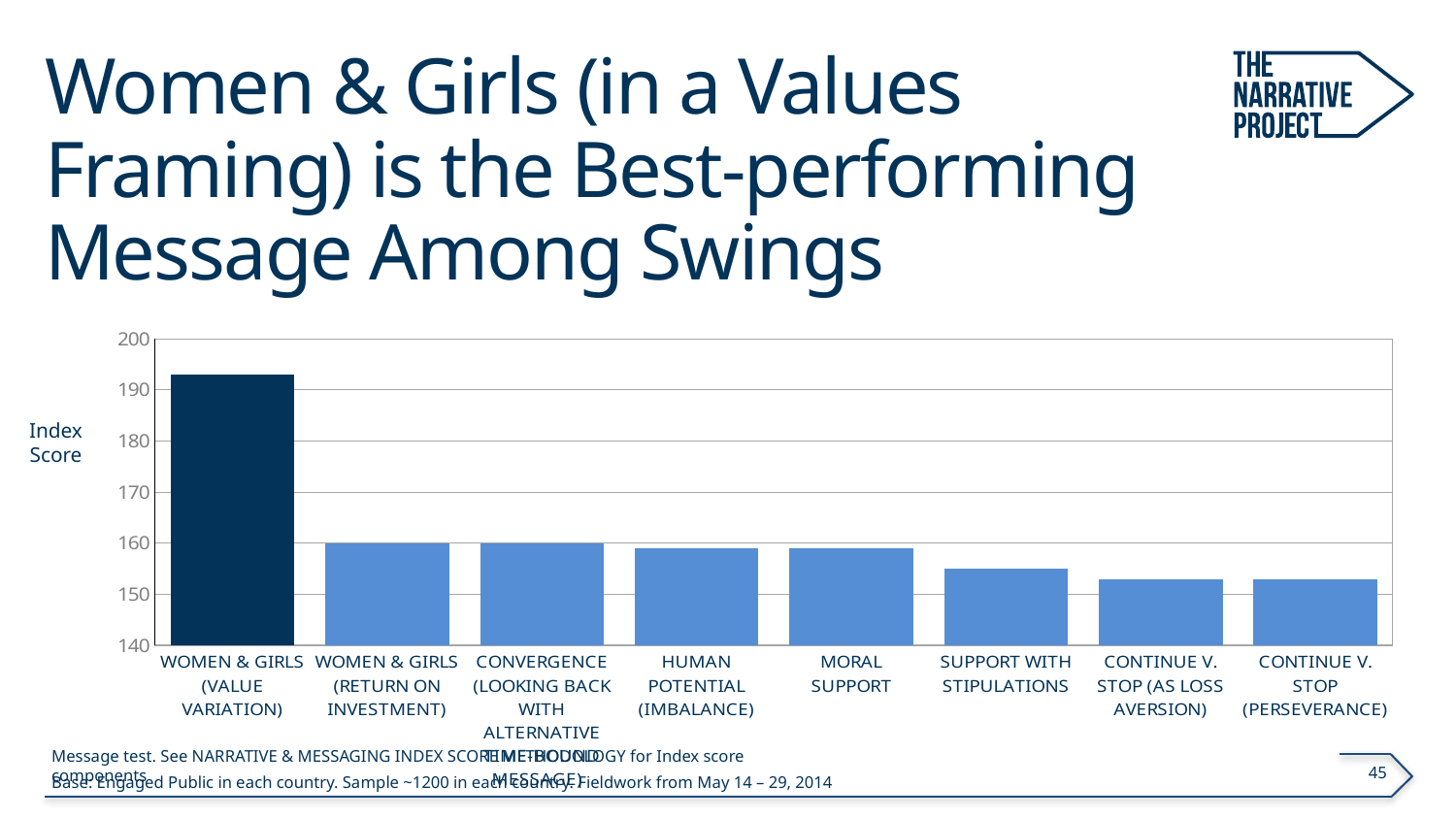
Which bar is shaded a darker blue than the others? Women & Girls (Value Variation) Is the index score for Continue v. Stop (Perseverance) greater or less than 150? greater What kind of chart is shown on the slide? bar chart Is the index score for Support with Stipulations greater or less than 160? less How many message categories are plotted on the chart? 8 Is the index score for Human Potential (Imbalance) greater or less than 170? less Do the index scores generally rise or fall moving from left to right across the chart? fall What label is shown on the vertical axis of the chart? Index Score Which has a higher index score, Women & Girls (Value Variation) or Moral Support? Women & Girls (Value Variation) Which message has the highest index score? Women & Girls (Value Variation)